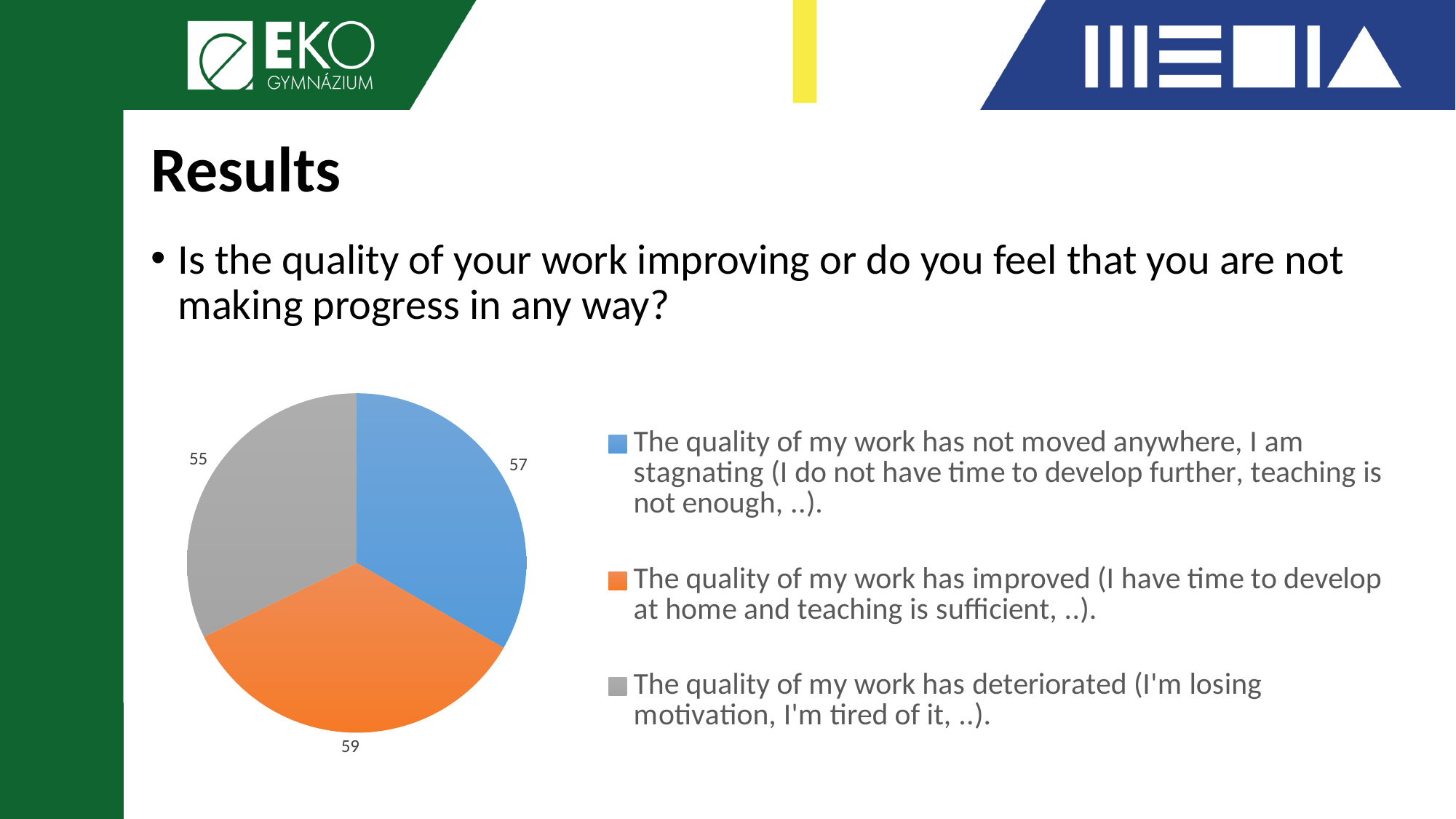
How many entries does the legend list? 3 Which colour represents 'The quality of my work has deteriorated' in the legend? gray Which response has the largest slice in the pie chart? The quality of my work has improved How many slices does the pie chart have? 3 What is the total of all three slices in the pie chart? 171 What kind of chart is shown on the slide? pie chart What is the value for the slice 'The quality of my work has not moved anywhere, I am stagnating'? 57 What is the value for the slice 'The quality of my work has deteriorated'? 55 What is the difference between the 'improved' slice and the 'deteriorated' slice? 4 Which is larger: the 'stagnating' slice or the 'deteriorated' slice? stagnating Which response has the smallest slice in the pie chart? The quality of my work has deteriorated What is the value for the slice 'The quality of my work has improved'? 59